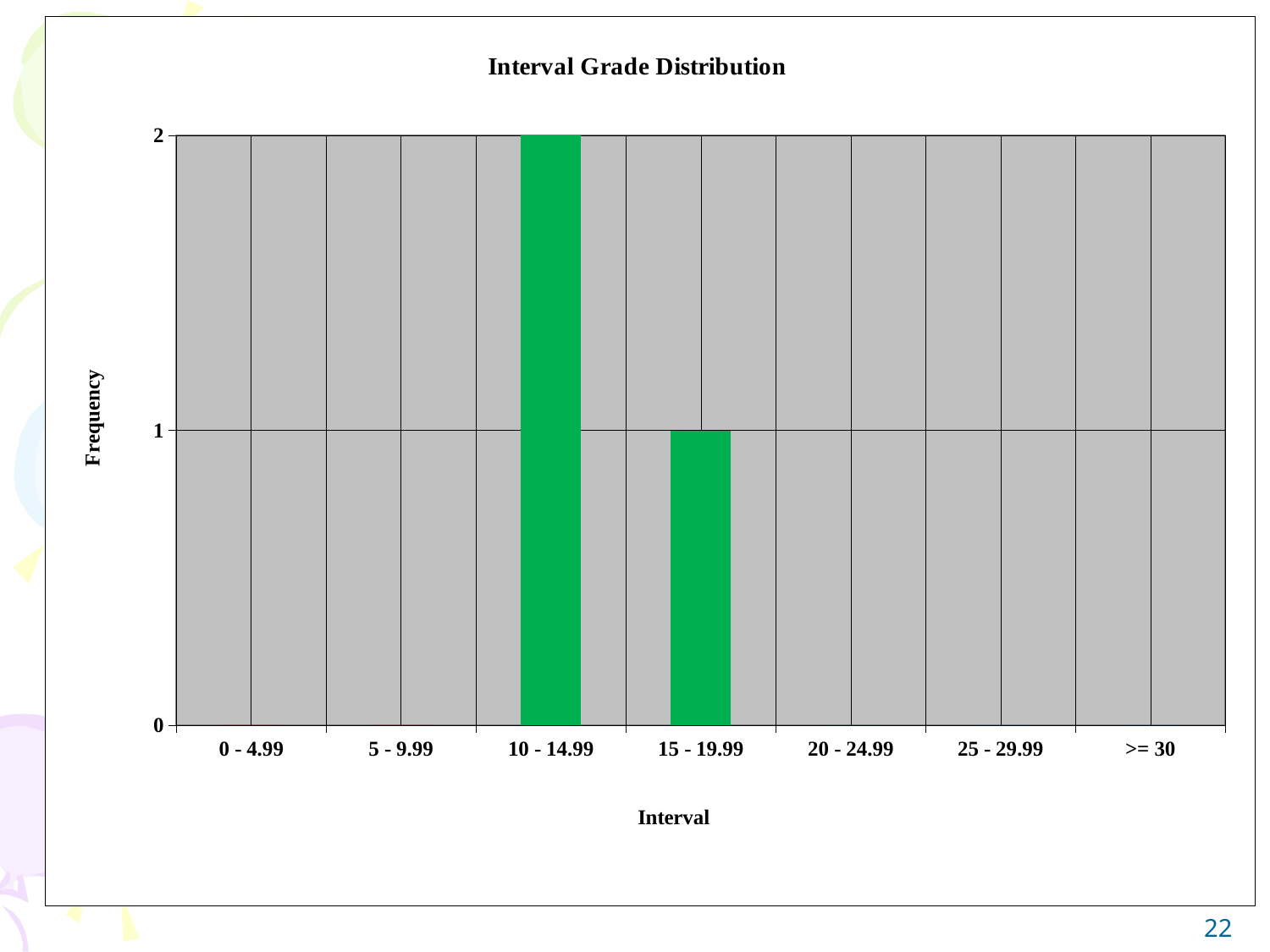
How many intervals have a frequency greater than 0? 2 What is the frequency for the 15 - 19.99 interval? 1 What kind of chart is shown on the slide? Bar chart What is the frequency for the 10 - 14.99 interval? 2 Which interval has the highest frequency? 10 - 14.99 What is the frequency for the >= 30 interval? 0 Which has a higher frequency, the 10 - 14.99 interval or the 15 - 19.99 interval? 10 - 14.99 What is the title of the chart? Interval Grade Distribution What is the frequency for the 0 - 4.99 interval? 0 What is the difference in frequency between the 10 - 14.99 and 15 - 19.99 intervals? 1 What is the label of the y axis? Frequency How many intervals are shown on the x axis? 7